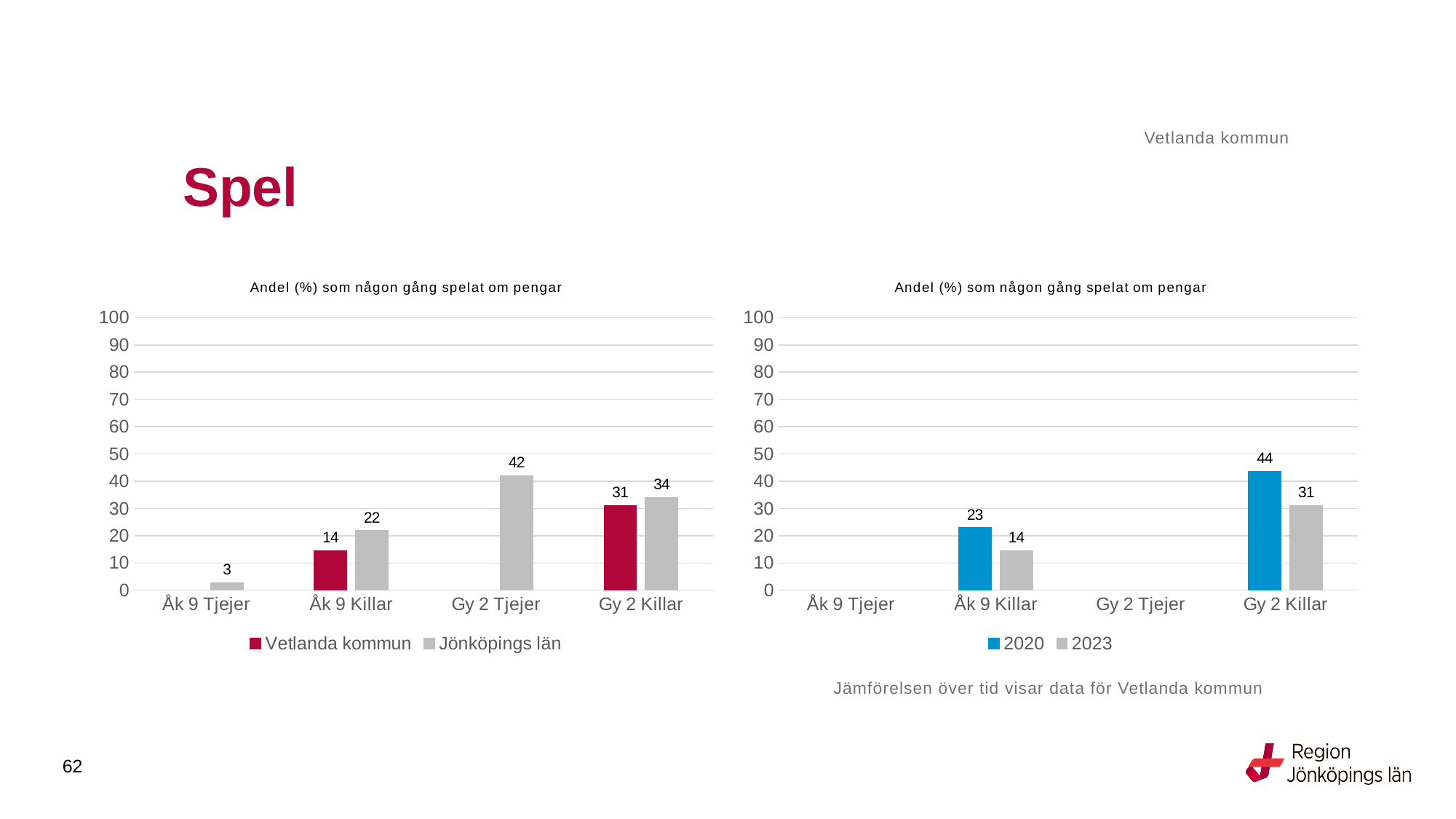
In the right chart, what is the value for 2020 for Gy 2 Killar? 44 How many categories are shown on the x axis of the right chart? 4 In the right chart, what is the value for 2023 for Åk 9 Killar? 14 In the left chart, for Åk 9 Killar, which is larger: Vetlanda kommun or Jönköpings län? Jönköpings län In the left chart, what is the difference between Jönköpings län and Vetlanda kommun for Gy 2 Killar? 3 In the left chart, which category has the lowest value for Jönköpings län? Åk 9 Tjejer In the left chart, what is the value for Jönköpings län for Gy 2 Tjejer? 42 In the left chart, what is the value for Vetlanda kommun for Åk 9 Killar? 14 What kind of chart is the right chart? Bar chart In the right chart, what is the difference between 2020 and 2023 for Åk 9 Killar? 9 How many series does the legend of the left chart list? 2 In the right chart, for Gy 2 Killar, which is larger: 2020 or 2023? 2020